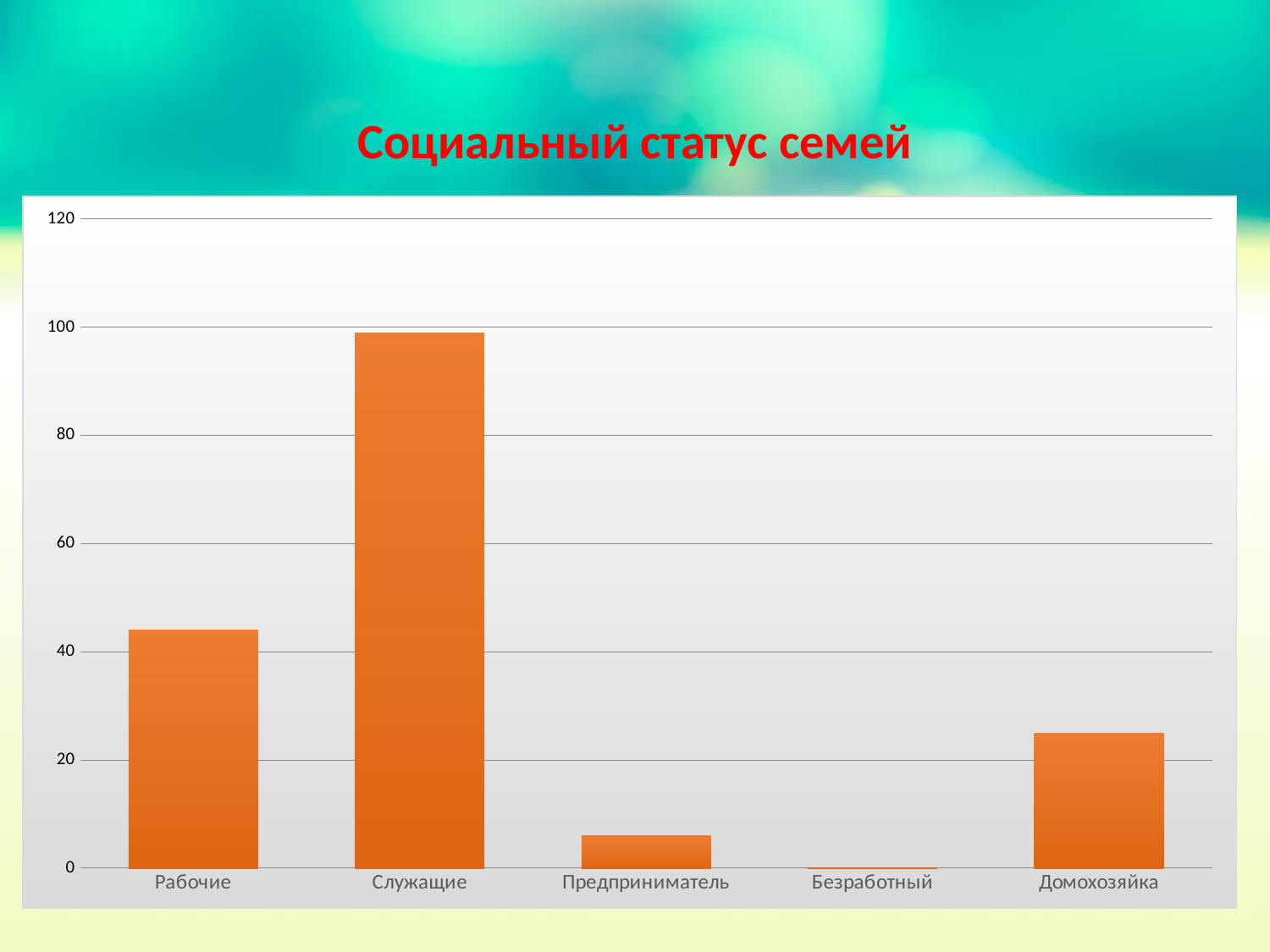
What is the title of the chart? Социальный статус семей How many categories are shown on the x axis of the chart? 5 Which is larger, the value for Предприниматель or the value for Домохозяйка? Домохозяйка Which category has the lowest value in the chart? Безработный What kind of chart is shown on the slide? bar chart Is the value for Рабочие greater or less than 40? greater Which category has the highest value in the chart? Служащие Is the value for Служащие greater or less than 80? greater Is the value for Домохозяйка greater or less than 20? greater Which is larger, the value for Рабочие or the value for Домохозяйка? Рабочие